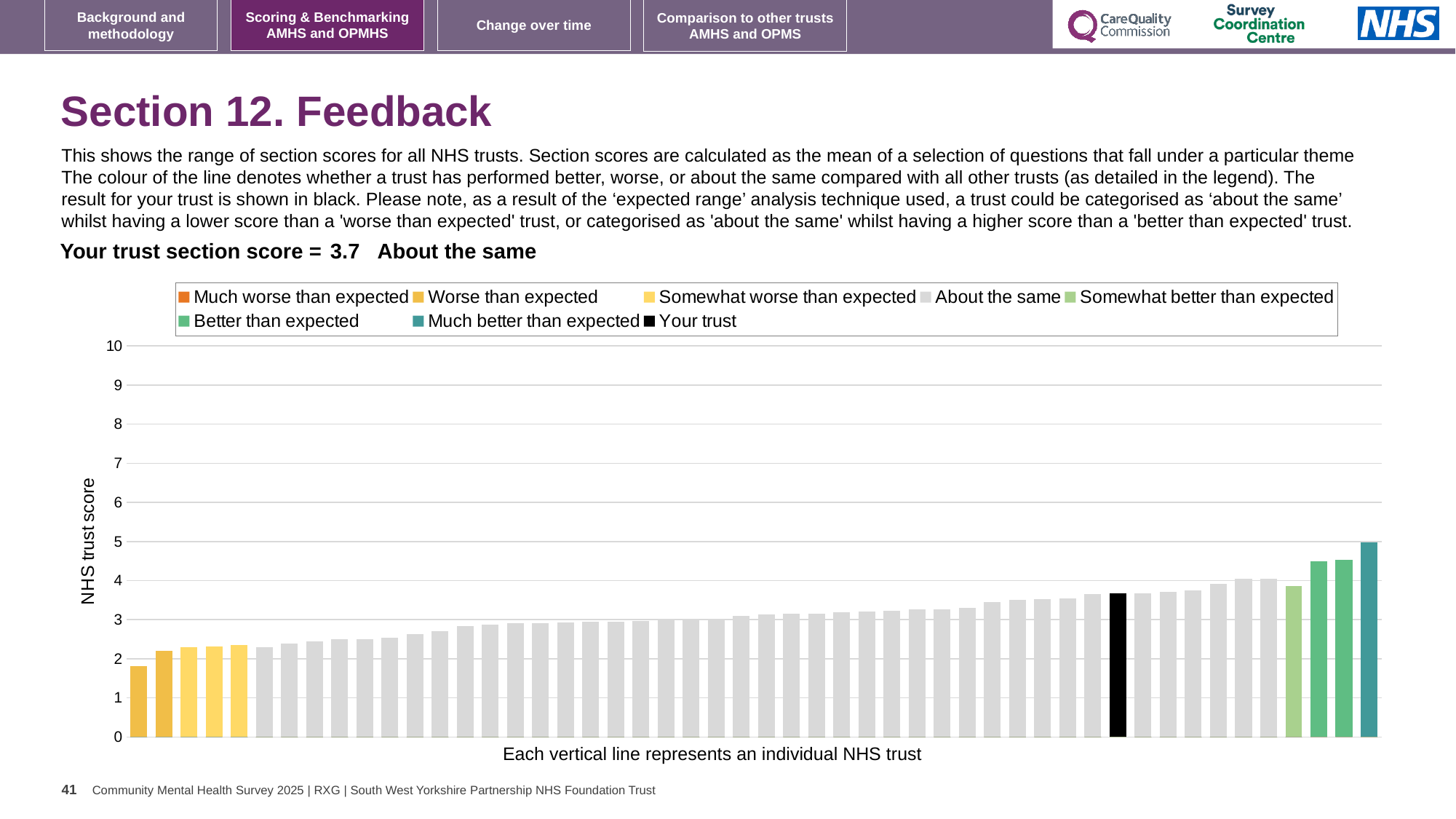
Is the value of the rightmost bar greater or less than 4? greater Which category is your trust placed in for this section? About the same Do the bar values rise or fall from left to right along the x axis? rise What is the label on the vertical axis of the chart? NHS trust score What is the highest value shown on the vertical axis? 10 What colour is used for the bar representing your trust? black Is the value of the leftmost bar greater or less than 2? less Which legend category does the tallest bar belong to? Much better than expected How many entries does the chart legend list? 8 What is the section score for your trust shown on the slide? 3.7 Is the value of the black bar (your trust) greater or less than 3? greater What kind of chart is shown on the slide? bar chart